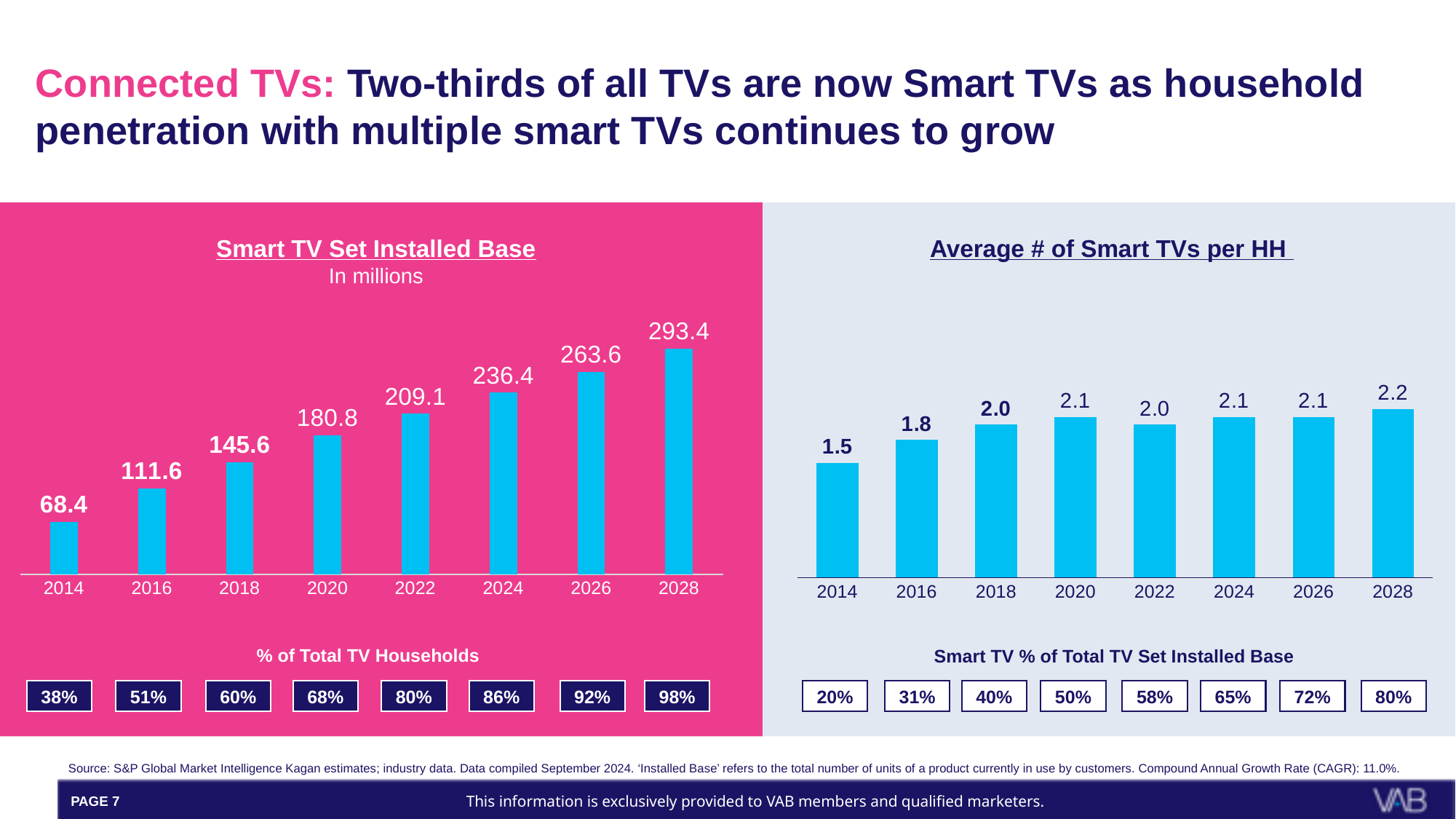
In the 'Average # of Smart TVs per HH' chart, what is the value for 2016? 1.8 In the 'Smart TV Set Installed Base' chart, do the values rise or fall from 2014 to 2028? rise In the 'Average # of Smart TVs per HH' chart, which is larger, the value for 2014 or the value for 2018? 2018 What type of chart is the 'Smart TV Set Installed Base' chart? bar chart In the 'Smart TV Set Installed Base' chart, what is the value for 2020? 180.8 In the 'Average # of Smart TVs per HH' chart, what is the value for 2028? 2.2 In the 'Smart TV Set Installed Base' chart, how many years are plotted? 8 In the 'Average # of Smart TVs per HH' chart, which year has the lowest value? 2014 In the 'Smart TV Set Installed Base' chart, what is the difference between the 2028 and 2014 values? 225 What unit is stated under the title of the 'Smart TV Set Installed Base' chart? In millions In the 'Smart TV Set Installed Base' chart, which year has the highest value? 2028 In the 'Smart TV Set Installed Base' chart, which year has the lowest value? 2014